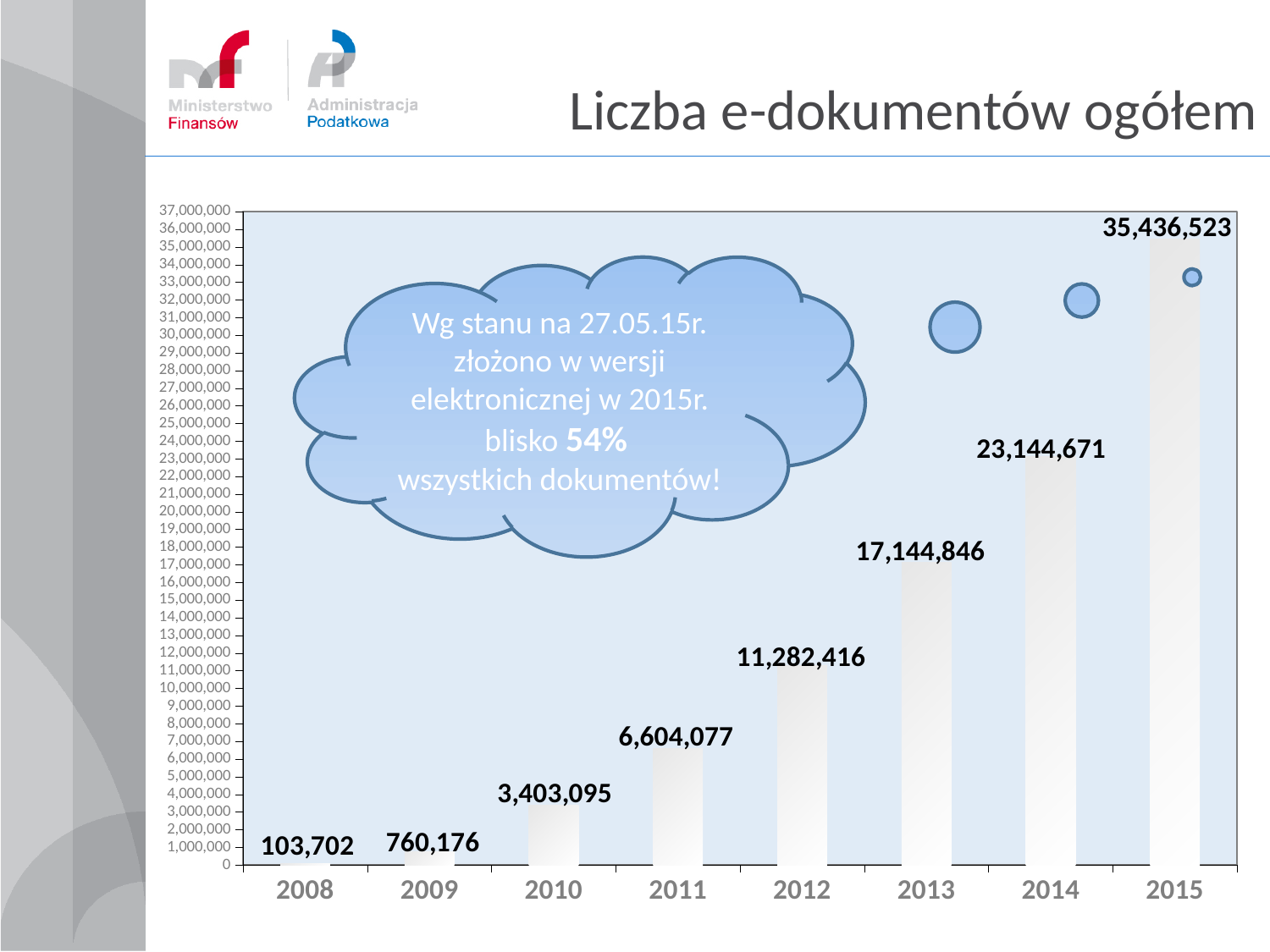
Do the values rise or fall from 2008 to 2015? rise What is the value for 2008? 103,702 What kind of chart is shown on the slide? bar chart What is the difference between the values for 2015 and 2014? 12,291,852 Which year has the highest value? 2015 What is the value for 2015? 35,436,523 What is the difference between the values for 2013 and 2012? 5,862,430 Is the value for 2012 greater or less than 10,000,000? greater Which is larger, the value for 2010 or the value for 2011? 2011 How many years are shown on the x axis? 8 Which year has the lowest value? 2008 What is the value for 2011? 6,604,077